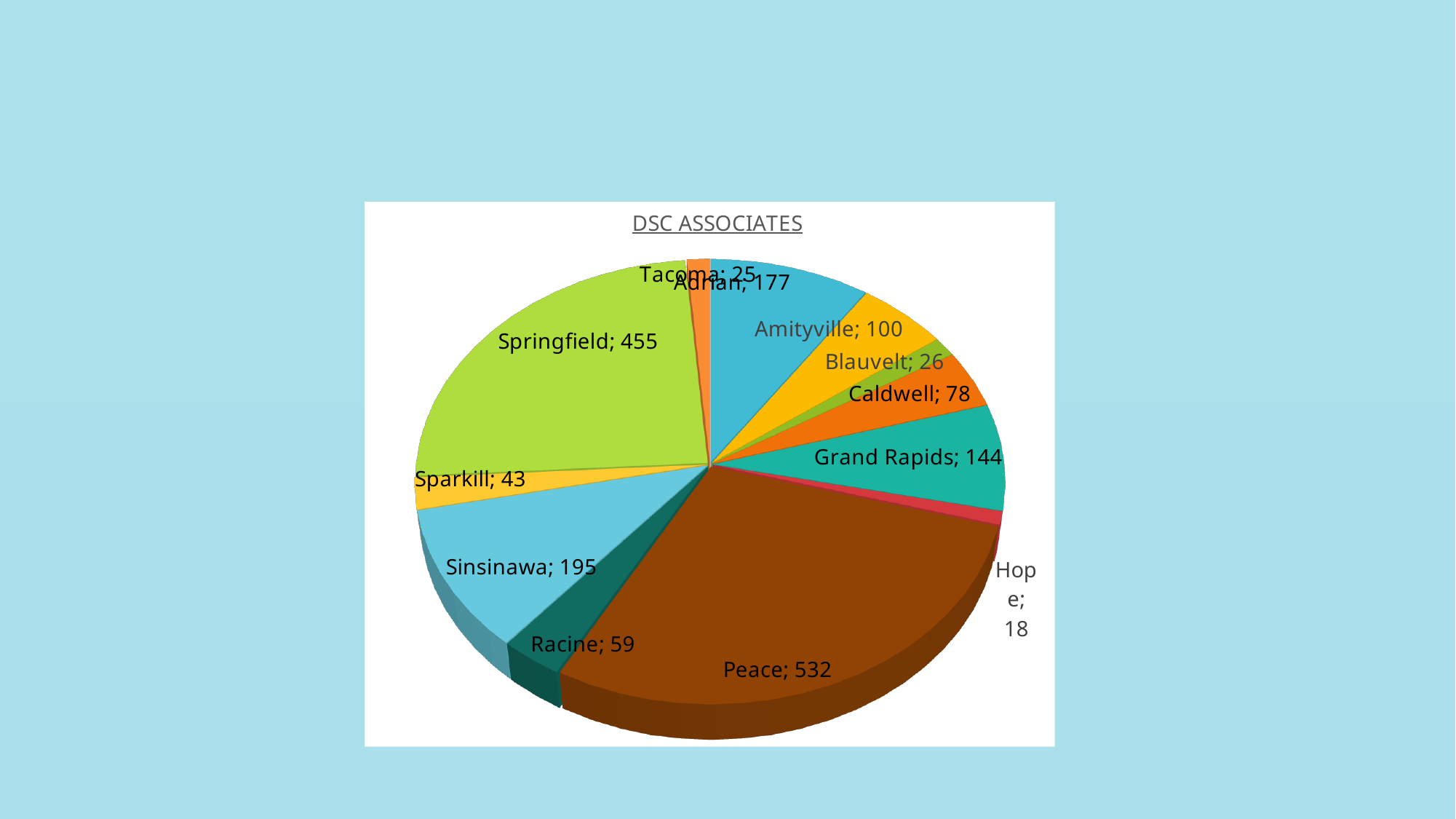
What is the difference between the values for Adrian and Racine? 118 What is the total of all the slice values in the chart? 1852 What is the title of the chart? DSC ASSOCIATES How many slices does the pie chart have? 12 What is the value for Springfield? 455 What is the difference between the values for Peace and Springfield? 77 What is the value for Grand Rapids? 144 Which is larger, the value for Amityville or the value for Caldwell? Amityville Which category has the largest slice? Peace What is the value for Sinsinawa? 195 Which category has the smallest slice? Hope What kind of chart is shown on the slide? pie chart